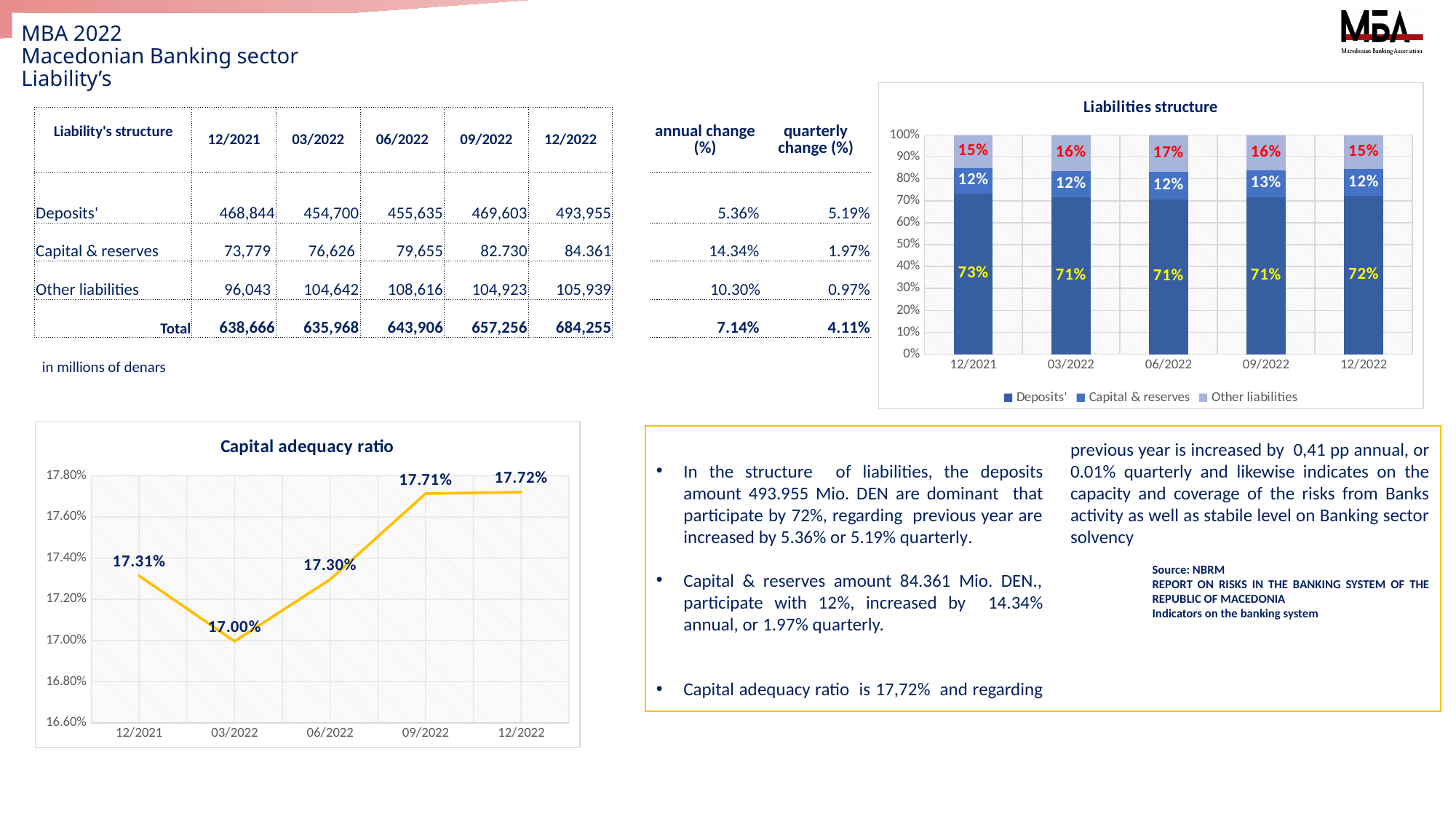
What type of chart is the "Liabilities structure" chart? Stacked bar chart In the "Liabilities structure" chart, what share do Other liabilities have in 06/2022? 17% In the "Liabilities structure" chart, what share do Deposits' have in 12/2021? 73% In the "Capital adequacy ratio" chart, what is the difference between the values for 09/2022 and 03/2022? 0.71% In the "Capital adequacy ratio" chart, is the value for 12/2022 higher or lower than the value for 12/2021? Higher In the "Liabilities structure" chart, what share do Capital & reserves have in 09/2022? 13% What type of chart is the "Capital adequacy ratio" chart? Line chart In the "Liabilities structure" chart, how many series does the legend list? 3 In the "Liabilities structure" chart, how many periods are shown on the x axis? 5 In the "Capital adequacy ratio" chart, which period has the lowest value? 03/2022 In the "Liabilities structure" chart, what is the difference between the Deposits' share in 12/2021 and in 03/2022? 2 percentage points In the "Capital adequacy ratio" chart, what is the value for 09/2022? 17.71%